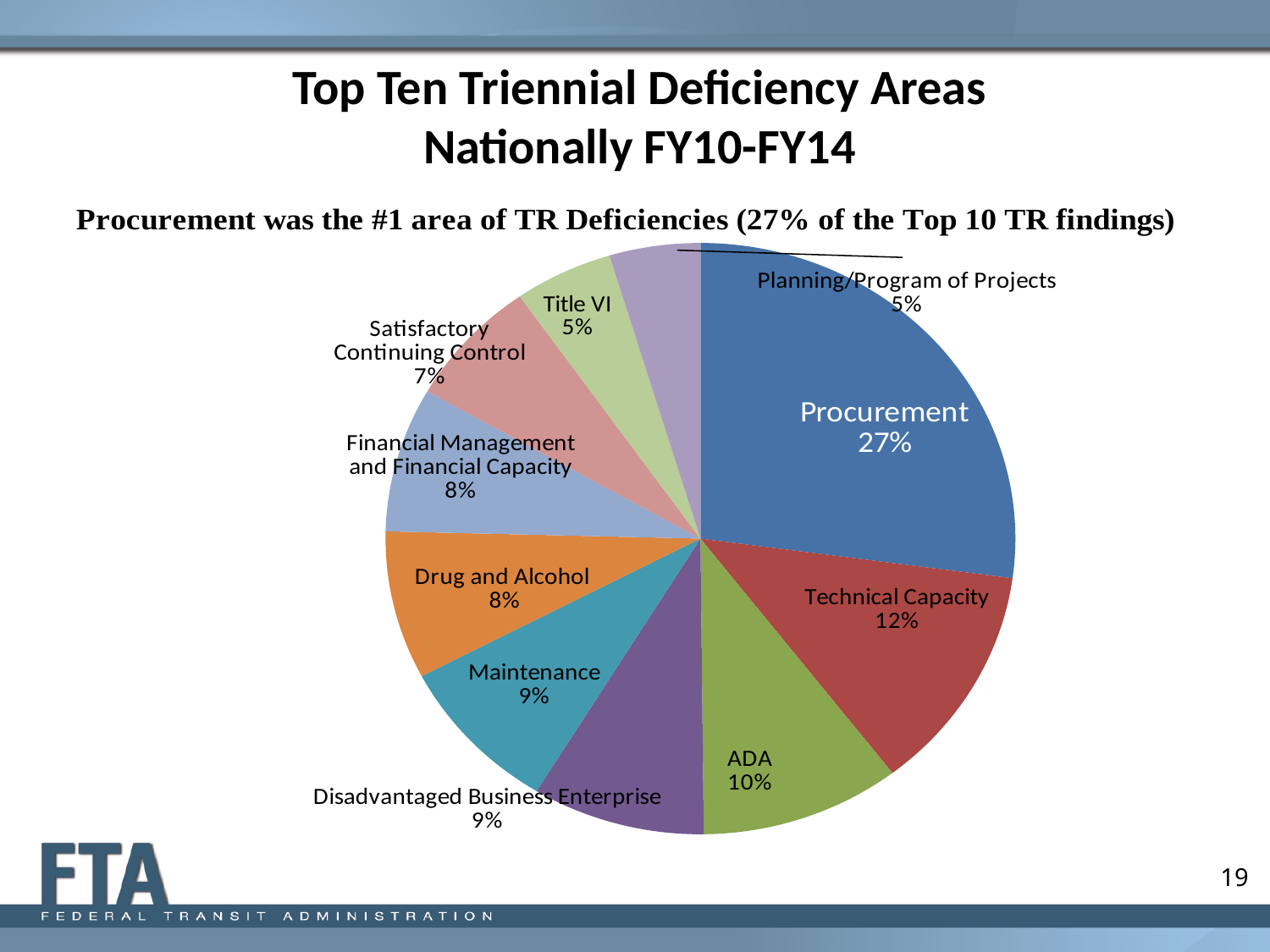
What is the difference in percentage points between Procurement and Technical Capacity? 15 Which deficiency area has the largest slice of the pie? Procurement What percentage is shown for Technical Capacity? 12% What percentage is shown for Title VI? 5% What percentage is shown for Satisfactory Continuing Control? 7% Which is larger, the share for Maintenance or the share for Drug and Alcohol? Maintenance What percentage is shown for ADA? 10% What kind of chart is shown on the slide? pie chart How many slices does the pie chart have? 10 Which is larger, the share for ADA or the share for Financial Management and Financial Capacity? ADA What share of the pie does Procurement account for? 27% What is the title of the chart on the slide? Top Ten Triennial Deficiency Areas Nationally FY10-FY14